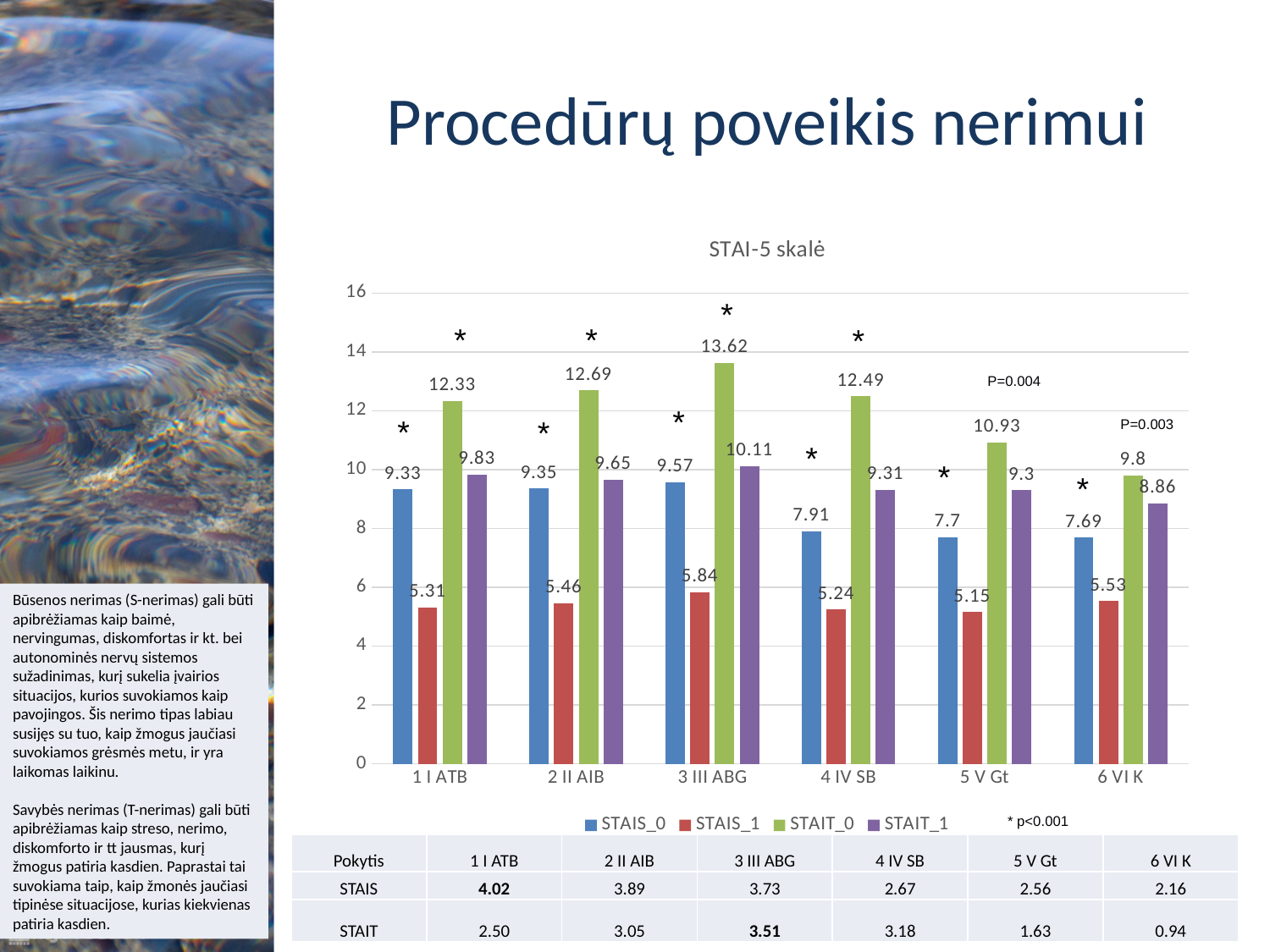
Is the STAIT_0 value for 5 V Gt greater or less than 10? greater How many series does the chart legend list? 4 What is the value of STAIT_1 for 6 VI K? 8.86 What is the difference between STAIS_0 and STAIS_1 for 1 I ATB? 4.02 What is the title of the chart? STAI-5 skalė How many categories are shown on the x axis of the chart? 6 Which category has the highest STAIT_0 value? 3 III ABG What is the value of STAIS_1 for 5 V Gt? 5.15 What is the value of STAIT_0 for 3 III ABG? 13.62 Which is larger for 4 IV SB: STAIT_0 or STAIT_1? STAIT_0 What type of chart is shown on the slide? bar chart Which category has the lowest STAIS_0 value? 6 VI K